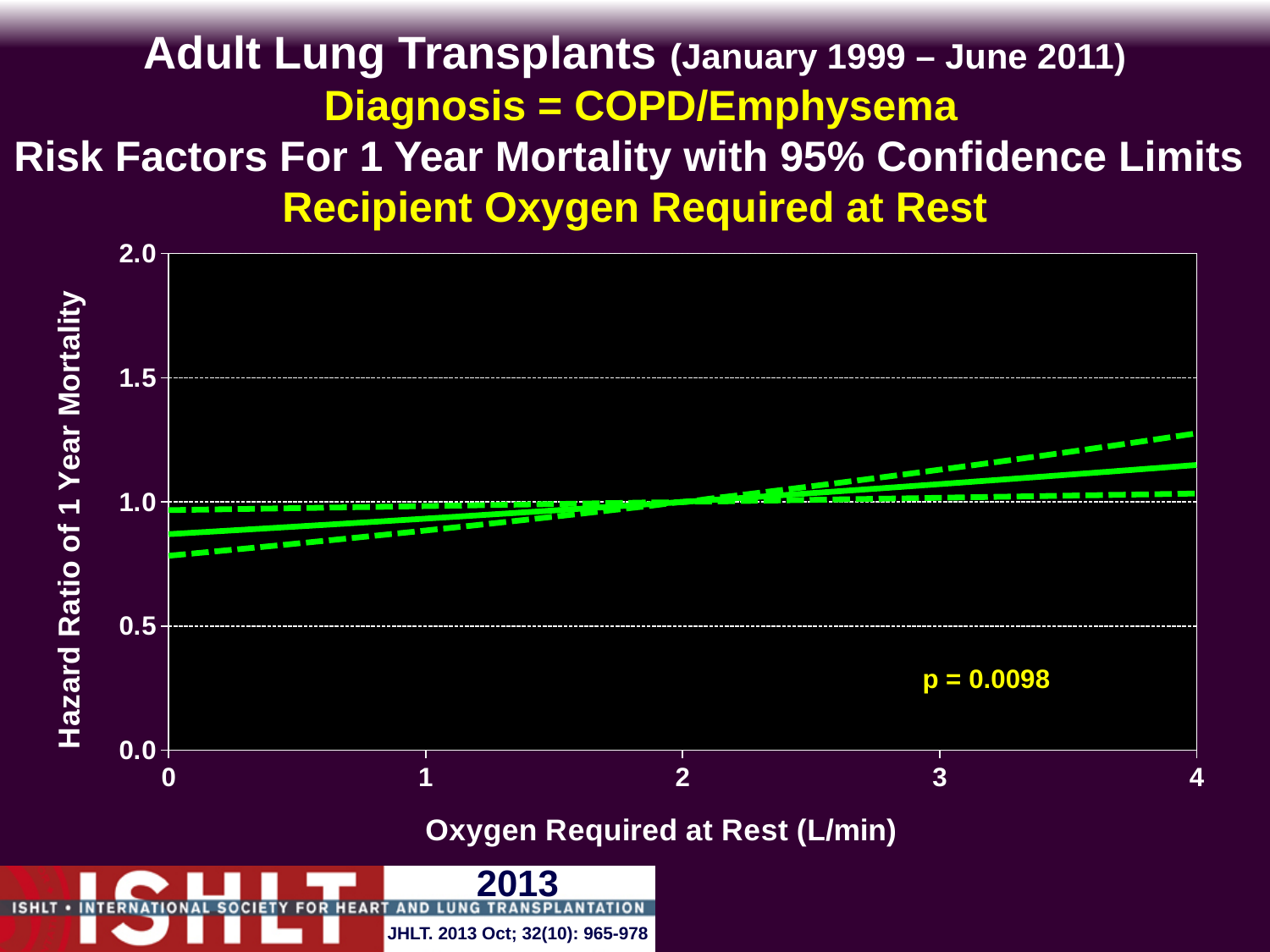
Is the hazard ratio at 4 L/min larger or smaller than the hazard ratio at 0 L/min? larger Does the hazard ratio of 1 year mortality rise or fall as oxygen required at rest increases from 0 to 4 L/min? rise Is the lower 95% confidence limit at 0 L/min oxygen required at rest greater or less than 0.5? greater Is the upper 95% confidence limit at 4 L/min oxygen required at rest greater or less than 1.5? less Is the hazard ratio (solid line) at 0 L/min oxygen required at rest greater or less than 1.0? less What kind of chart is shown on the slide? line chart How many lines are plotted on the chart (the estimate plus its confidence limits)? 3 What p-value is printed on the chart? p = 0.0098 What is the maximum value shown on the y axis of the chart? 2.0